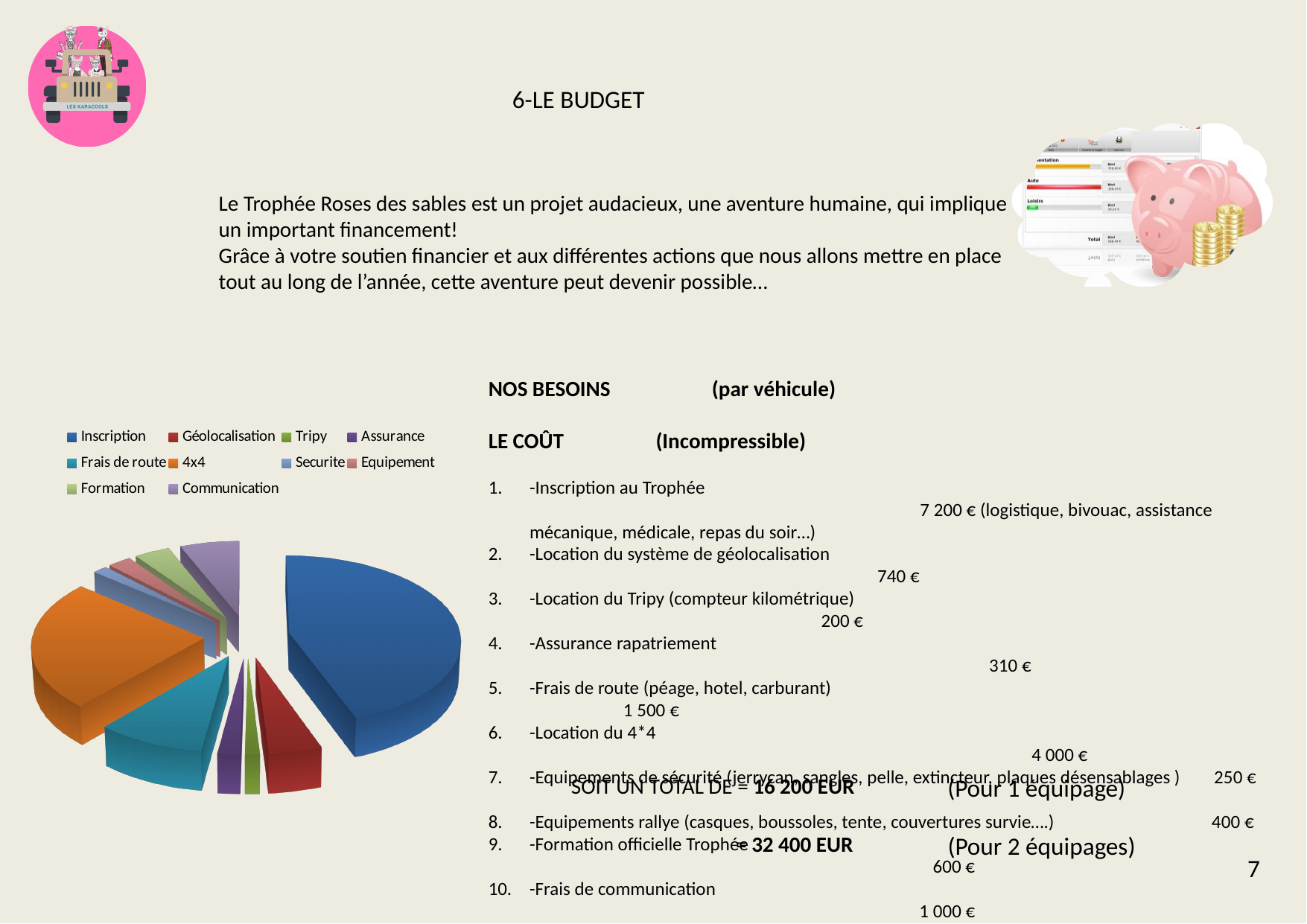
In the pie chart, which slice is larger: Inscription or 4x4? Inscription How many categories does the pie chart's legend list? 10 In the pie chart, which slice is larger: Frais de route or Géolocalisation? Frais de route What colour is the 4x4 slice in the pie chart? orange Which category has the largest slice in the pie chart? Inscription In the pie chart, which slice is larger: 4x4 or Frais de route? 4x4 What colour is the Inscription slice in the pie chart? blue What kind of chart is shown on the slide? pie chart Which category has the second-largest slice in the pie chart? 4x4